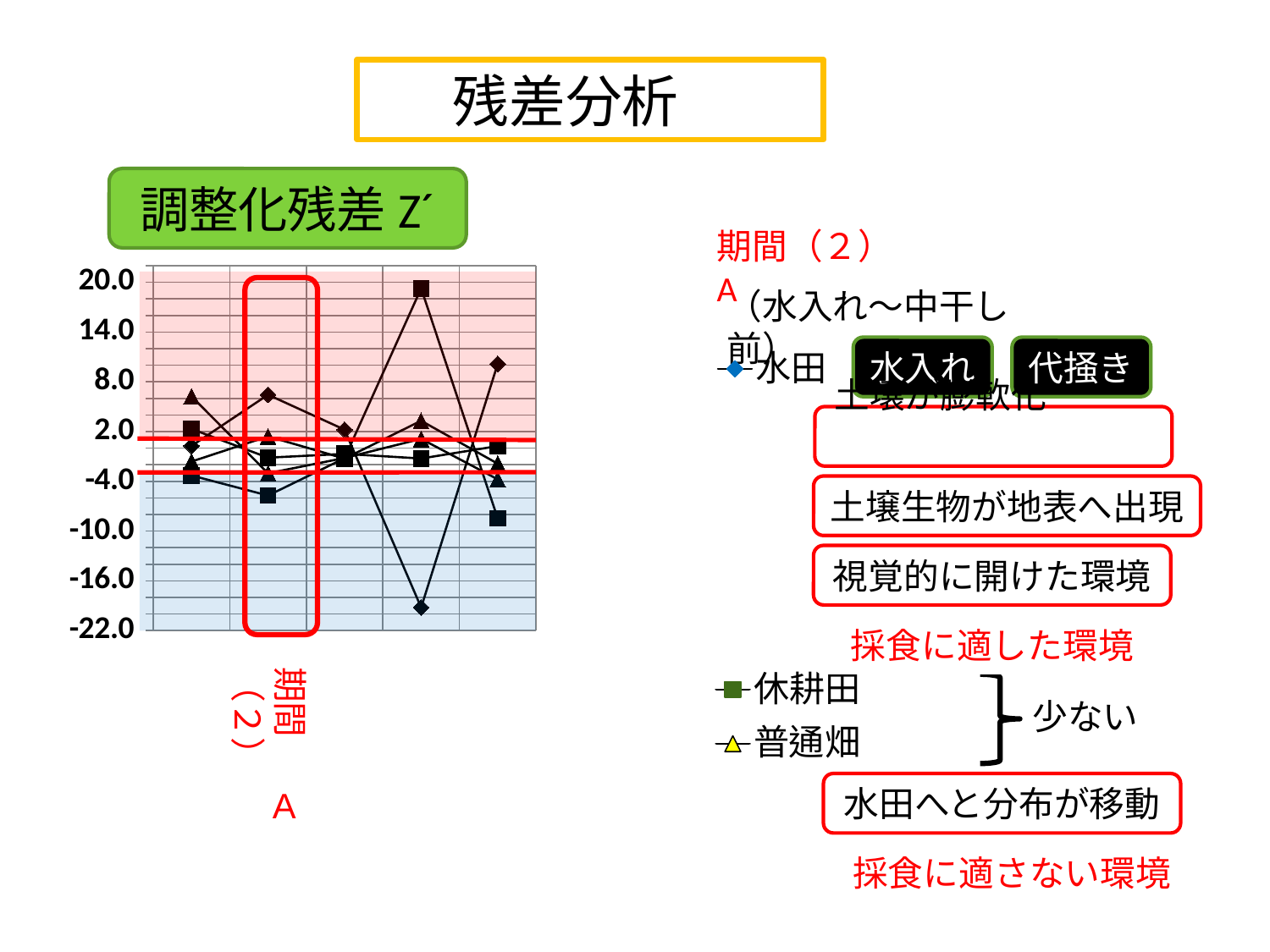
What is the lowest value shown on the chart's vertical axis? -22.0 What kind of chart is shown on the slide? line chart How many series does the chart's legend list? 3 What are the three series named in the chart's legend? 水田, 休耕田, 普通畑 Is the lowest plotted point on the chart greater or less than -16.0? less Is the highest plotted point on the chart greater or less than 14.0? greater What is the title shown above the chart? 調整化残差 Z′ What is the highest value shown on the chart's vertical axis? 20.0 How many x-axis positions (time periods) are plotted on the chart? 5